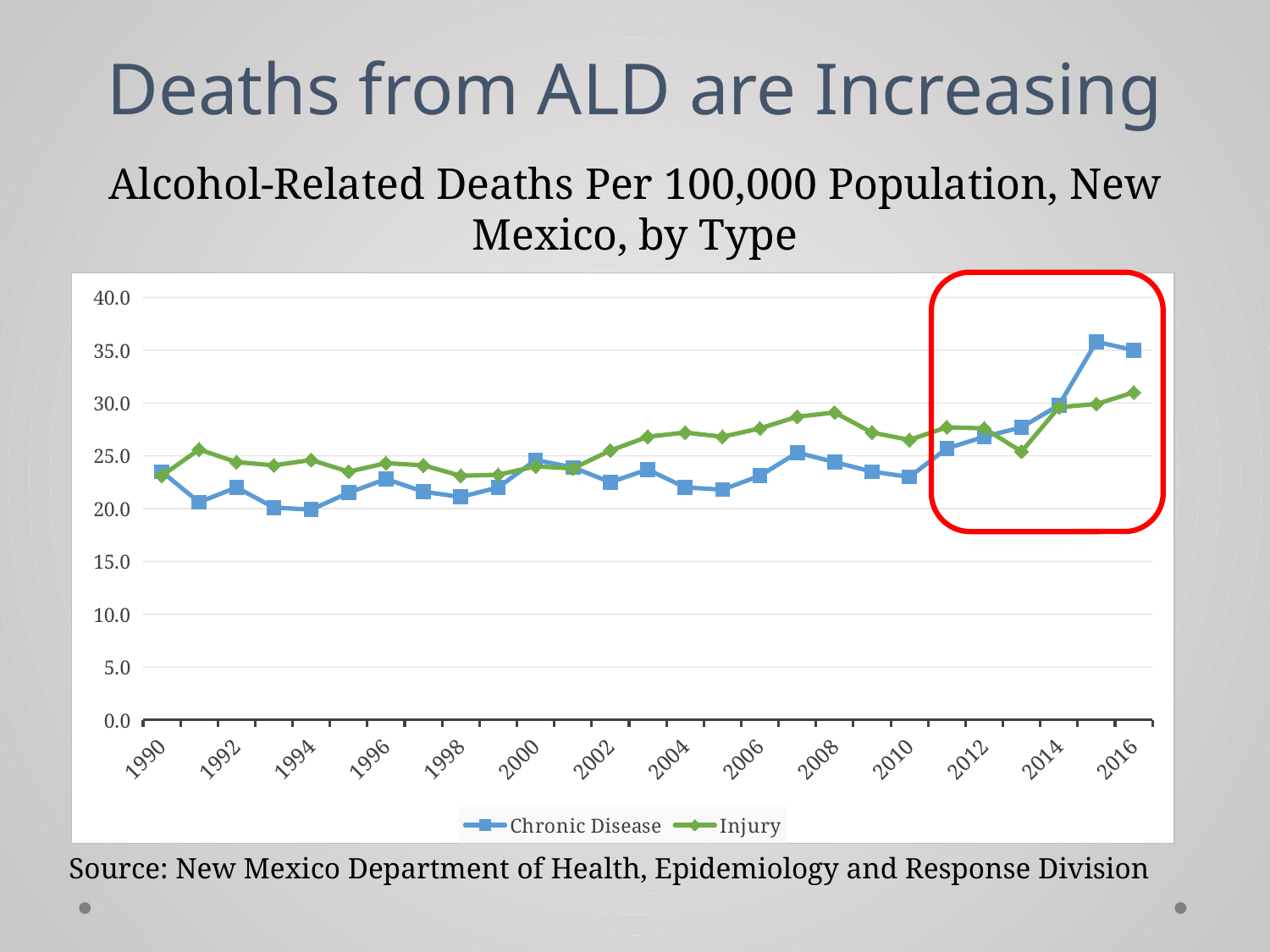
Which two series are listed in the legend? Chronic Disease and Injury How many series does the legend list? 2 What is the first year shown on the x axis? 1990 In which year does the Chronic Disease series reach its highest value? 2015 Is the Chronic Disease value for 2005 greater or less than 25.0? less What kind of chart is shown on the slide? Line chart Is the Injury value for 2008 greater or less than 30.0? less Is the Chronic Disease value for 1990 greater or less than 25.0? less Does the Chronic Disease series rise or fall between 2010 and 2015? Rise In 2016, which series has the higher value, Chronic Disease or Injury? Chronic Disease In 2008, which series has the higher value, Chronic Disease or Injury? Injury